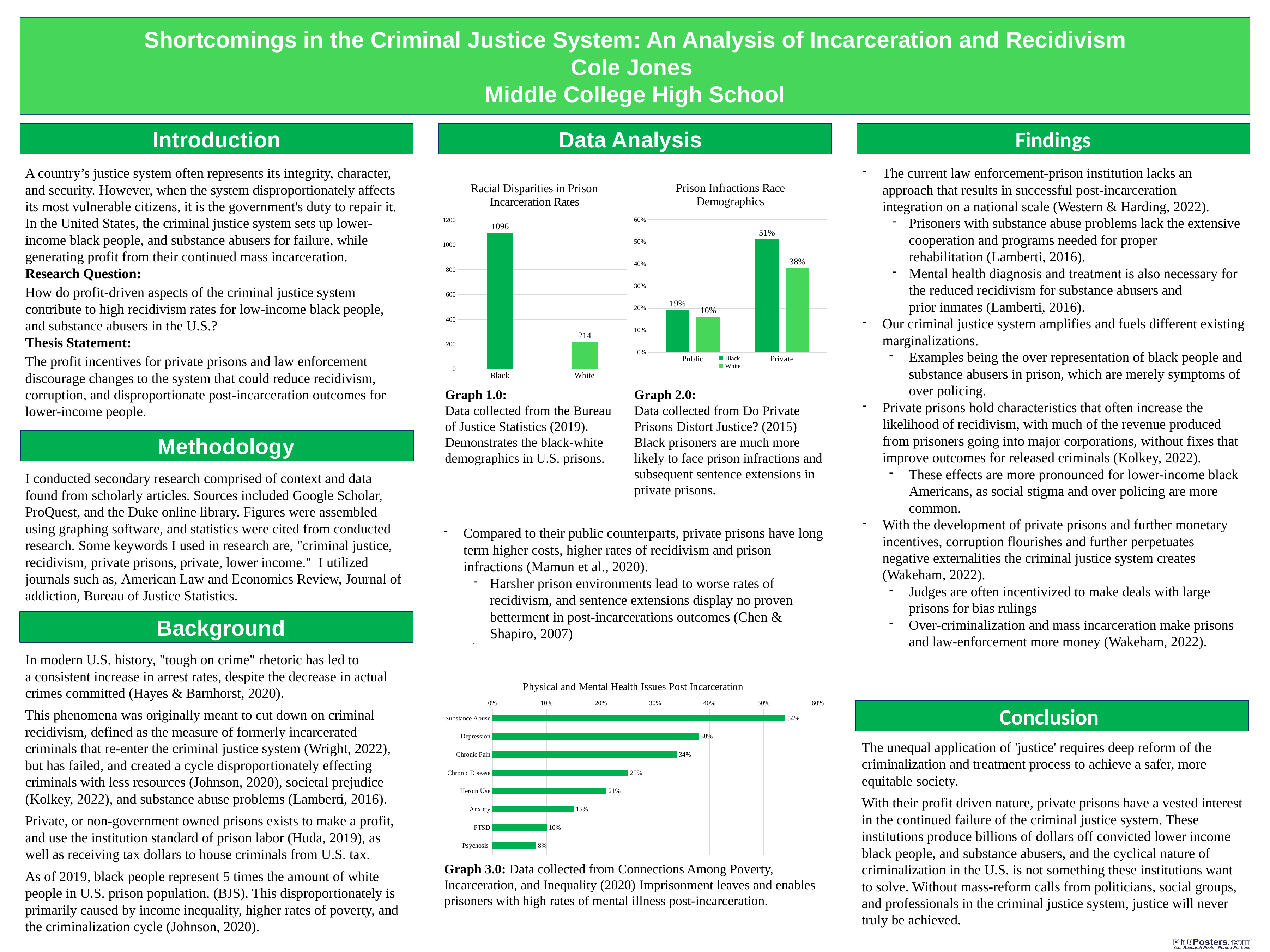
In the 'Physical and Mental Health Issues Post Incarceration' chart, which category has the highest value? Substance Abuse What kind of chart is 'Racial Disparities in Prison Incarceration Rates'? bar chart How many series does the legend of the 'Prison Infractions Race Demographics' chart list? 2 In the 'Racial Disparities in Prison Incarceration Rates' chart, what is the difference between the Black and White values? 882 In the 'Prison Infractions Race Demographics' chart, what is the value for White in Public prisons? 16% In the 'Prison Infractions Race Demographics' chart, which is larger: Black in Public or White in Private? White in Private In the 'Physical and Mental Health Issues Post Incarceration' chart, what is the value for Chronic Pain? 34% In the 'Racial Disparities in Prison Incarceration Rates' chart, what is the value for Black? 1096 In the 'Physical and Mental Health Issues Post Incarceration' chart, which category has the lowest value? Psychosis In the 'Prison Infractions Race Demographics' chart, what is the value for Black in Private prisons? 51% How many categories are shown in the 'Physical and Mental Health Issues Post Incarceration' chart? 8 In the 'Physical and Mental Health Issues Post Incarceration' chart, what is the difference between Depression and Heroin Use? 17%